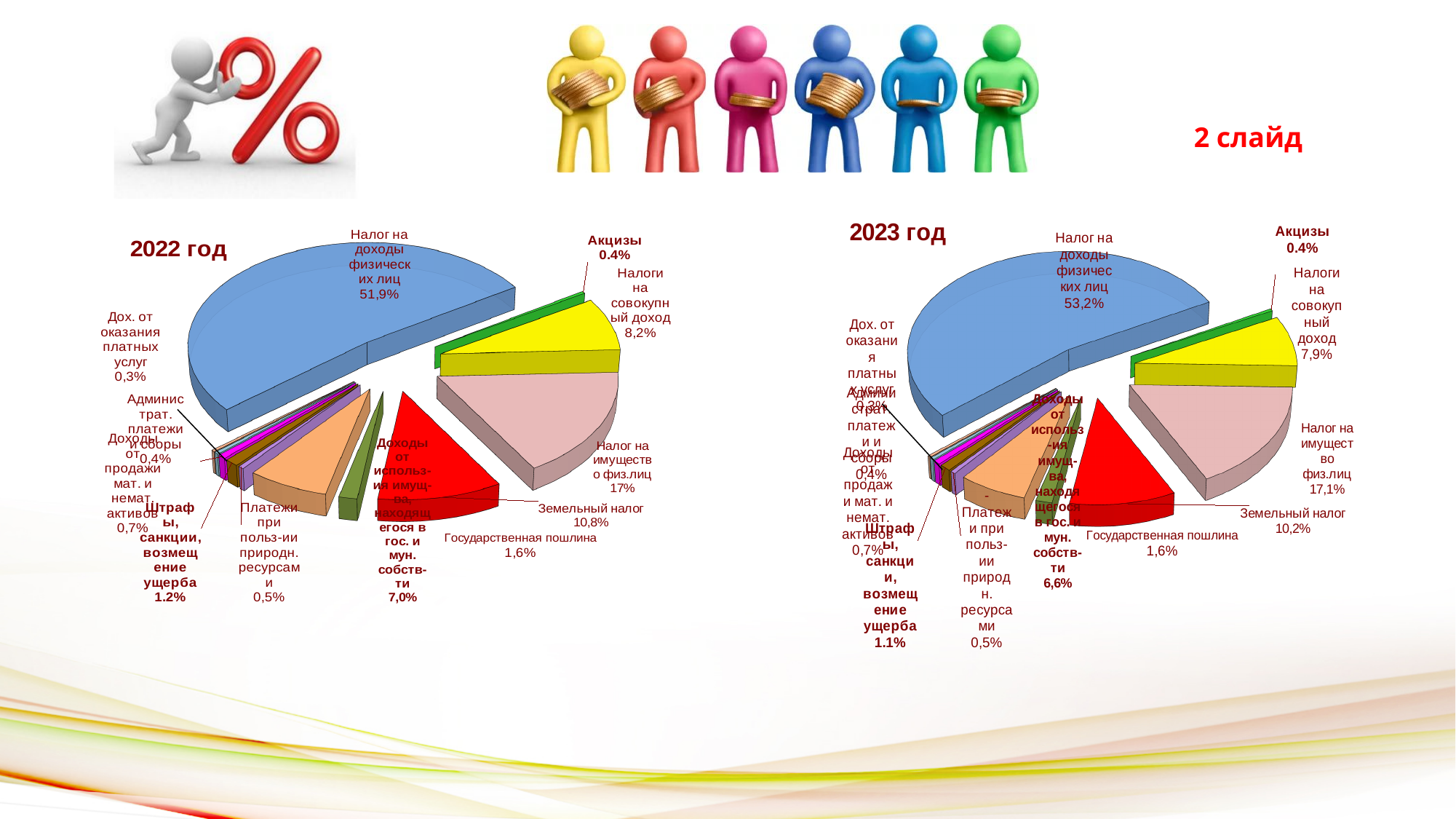
What type of chart is used for the 2022 год data? Pie chart In the 2022 год pie chart, which is larger: Налог на имущество физ.лиц or Земельный налог? Налог на имущество физ.лиц In the 2023 год pie chart, what is the value for Налог на имущество физ.лиц? 17,1% In the 2022 год pie chart, what is the value for Земельный налог? 10,8% What is the title of the chart on the right side of the slide? 2023 год In the 2023 год pie chart, what share is shown for Налог на доходы физических лиц? 53,2% In the 2022 год pie chart, what share is shown for Налог на доходы физических лиц? 51,9% In the 2023 год pie chart, what is the difference between Налог на имущество физ.лиц and Земельный налог? 6,9% In the 2022 год pie chart, what is the value for Государственная пошлина? 1,6% In the 2023 год pie chart, which category has the largest share? Налог на доходы физических лиц In the 2022 год pie chart, which category has the largest share? Налог на доходы физических лиц In the 2023 год pie chart, what is the value for Налоги на совокупный доход? 7,9%